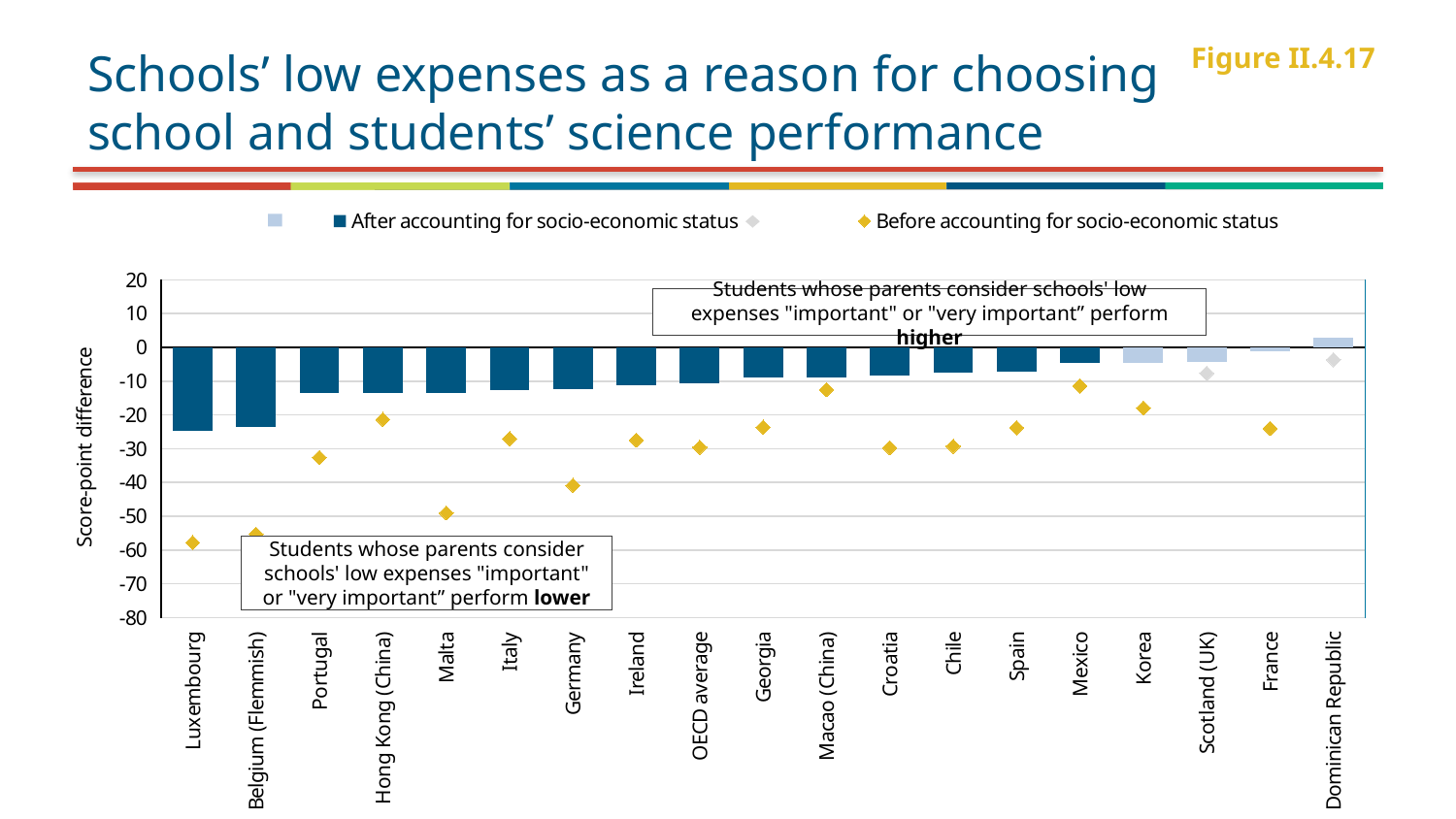
Is the 'Before accounting for socio-economic status' value for Hong Kong (China) greater or less than -30? greater Is the 'After accounting for socio-economic status' value for Luxembourg greater or less than -20? less Do the 'After accounting for socio-economic status' bars generally rise or fall moving from left to right along the x axis? rise What kind of chart is used to show the 'After accounting for socio-economic status' series? bar chart Is the 'After accounting for socio-economic status' value for Mexico greater or less than -10? greater How many countries/economies (categories) are shown on the x axis of the chart? 19 Which has the larger 'Before accounting for socio-economic status' value, Malta or Italy? Italy How many named series does the chart legend list? 2 Which category has the lowest value for 'Before accounting for socio-economic status'? Luxembourg